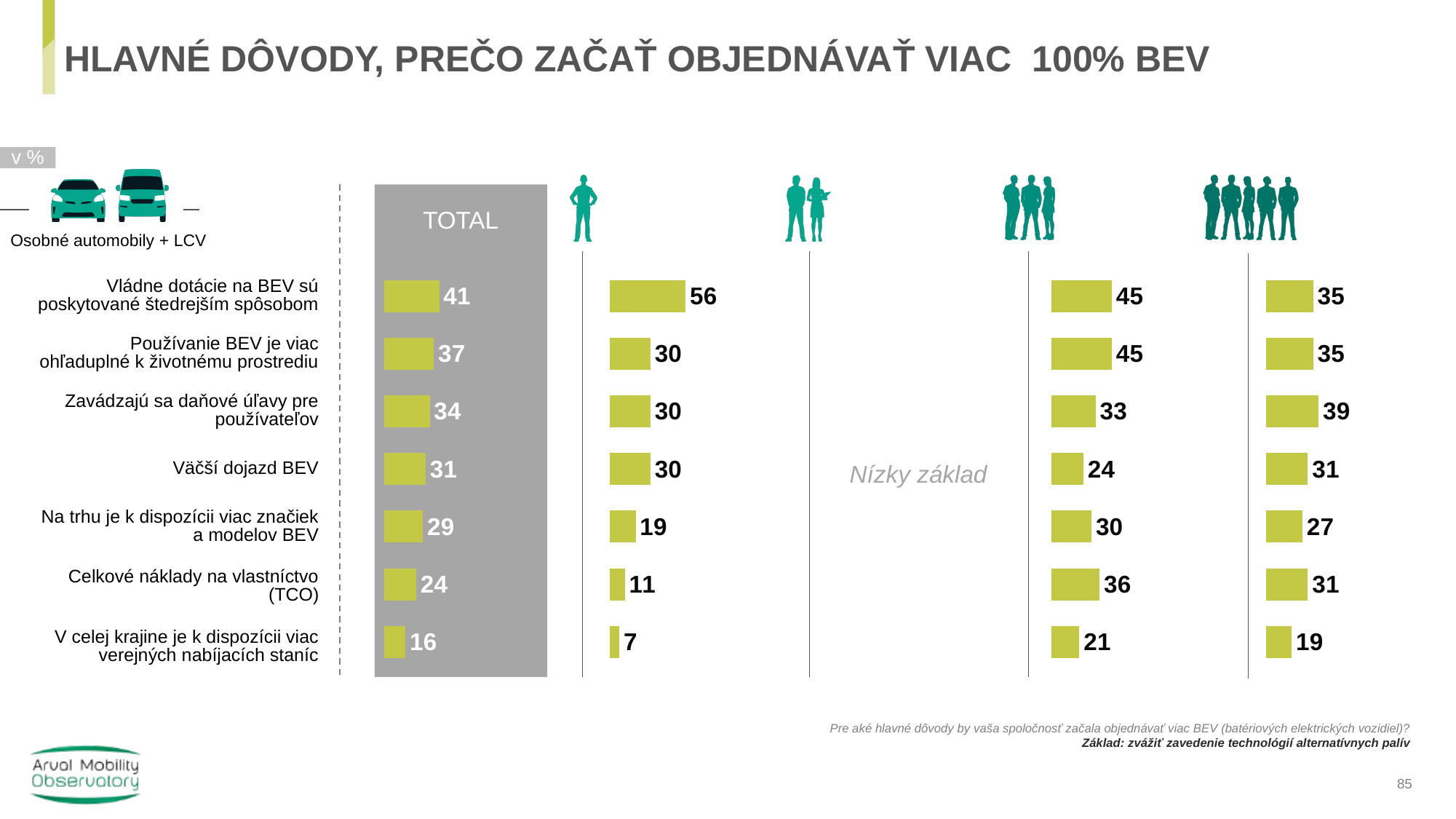
In the rightmost column (group of five people icon), what is the value for 'Zavádzajú sa daňové úľavy pre používateľov'? 39 What kind of chart is used on this slide? bar chart In the column with the three-person icon, is the value for 'Celkové náklady na vlastníctvo (TCO)' larger or smaller than the value for 'Väčší dojazd BEV'? larger In the column with the single-person icon (first column right of TOTAL), what is the value for 'Vládne dotácie na BEV sú poskytované štedrejším spôsobom'? 56 In the rightmost column (group of five people icon), which reason has the highest value? Zavádzajú sa daňové úľavy pre používateľov In the TOTAL column, which reason has the highest value? Vládne dotácie na BEV sú poskytované štedrejším spôsobom What text is shown in place of data in the column with the two-person icon? Nízky základ How many reasons (categories) are listed in the chart? 7 In the TOTAL column, which reason has the lowest value? V celej krajine je k dispozícii viac verejných nabíjacích staníc What is the difference between the TOTAL value for 'Vládne dotácie na BEV sú poskytované štedrejším spôsobom' (41) and the TOTAL value for 'V celej krajine je k dispozícii viac verejných nabíjacích staníc' (16)? 25 In the TOTAL column, what is the value for 'Vládne dotácie na BEV sú poskytované štedrejším spôsobom'? 41 In the TOTAL column, what is the value for 'Celkové náklady na vlastníctvo (TCO)'? 24